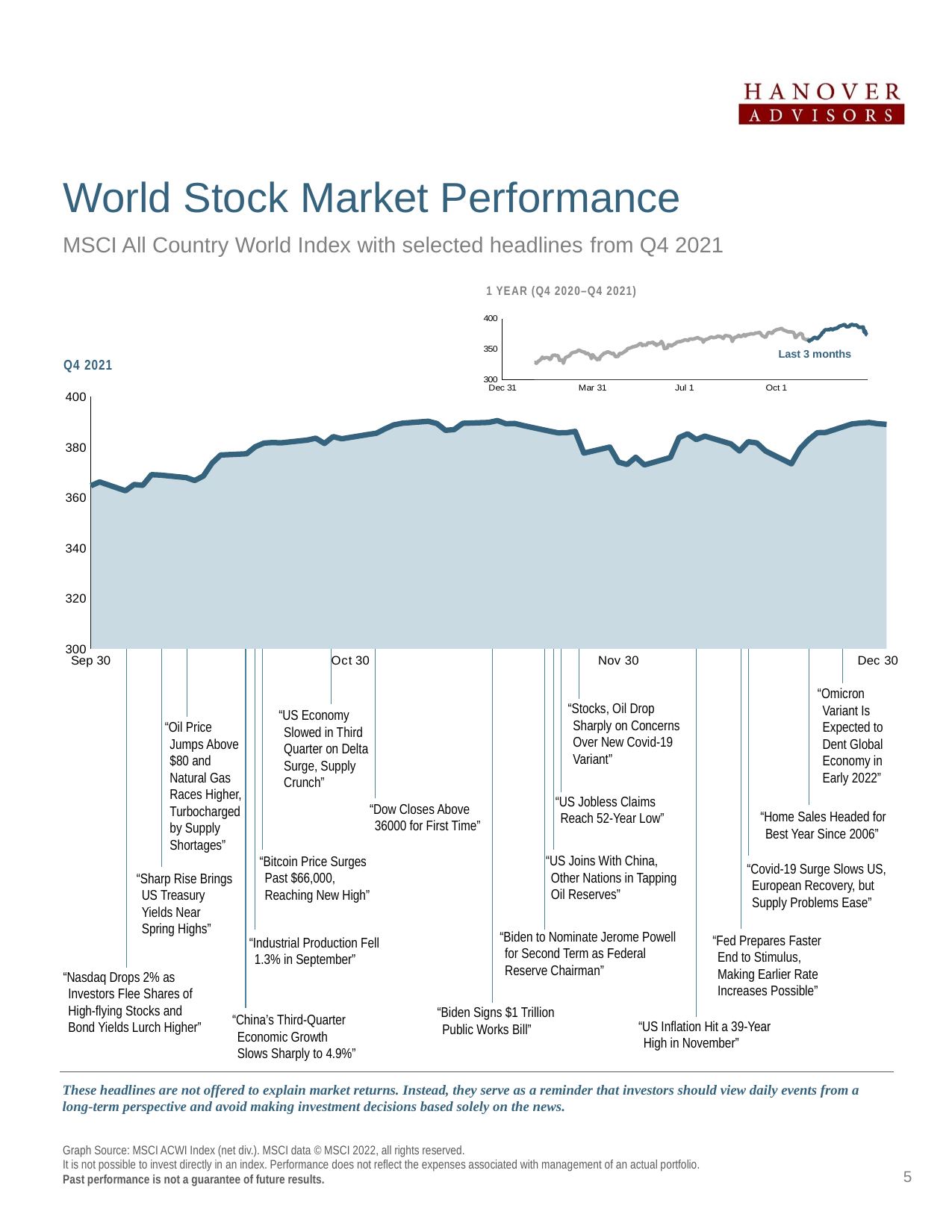
On the Q4 2021 chart, is the value at Dec 30 greater or less than 380? greater On the 1 YEAR (Q4 2020–Q4 2021) inset chart, is the value at Dec 31 greater or less than 350? less On the Q4 2021 chart, do values overall rise or fall from Sep 30 to Dec 30? Rise How many date labels are shown on the x axis of the Q4 2021 chart? 4 What is the title of the inset chart at the top right? 1 YEAR (Q4 2020–Q4 2021) On the Q4 2021 chart, is the value at Sep 30 greater or less than 380? less What label is shown next to the darker segment of the line in the inset chart? Last 3 months What kind of chart is the small inset chart titled 1 YEAR (Q4 2020–Q4 2021)? Line chart On the 1 YEAR (Q4 2020–Q4 2021) inset chart, do values overall rise or fall from Dec 31 to the end of the period? Rise What kind of chart is the large Q4 2021 chart? Area chart On the Q4 2021 chart, which is larger, the value at Sep 30 or the value at Dec 30? Dec 30